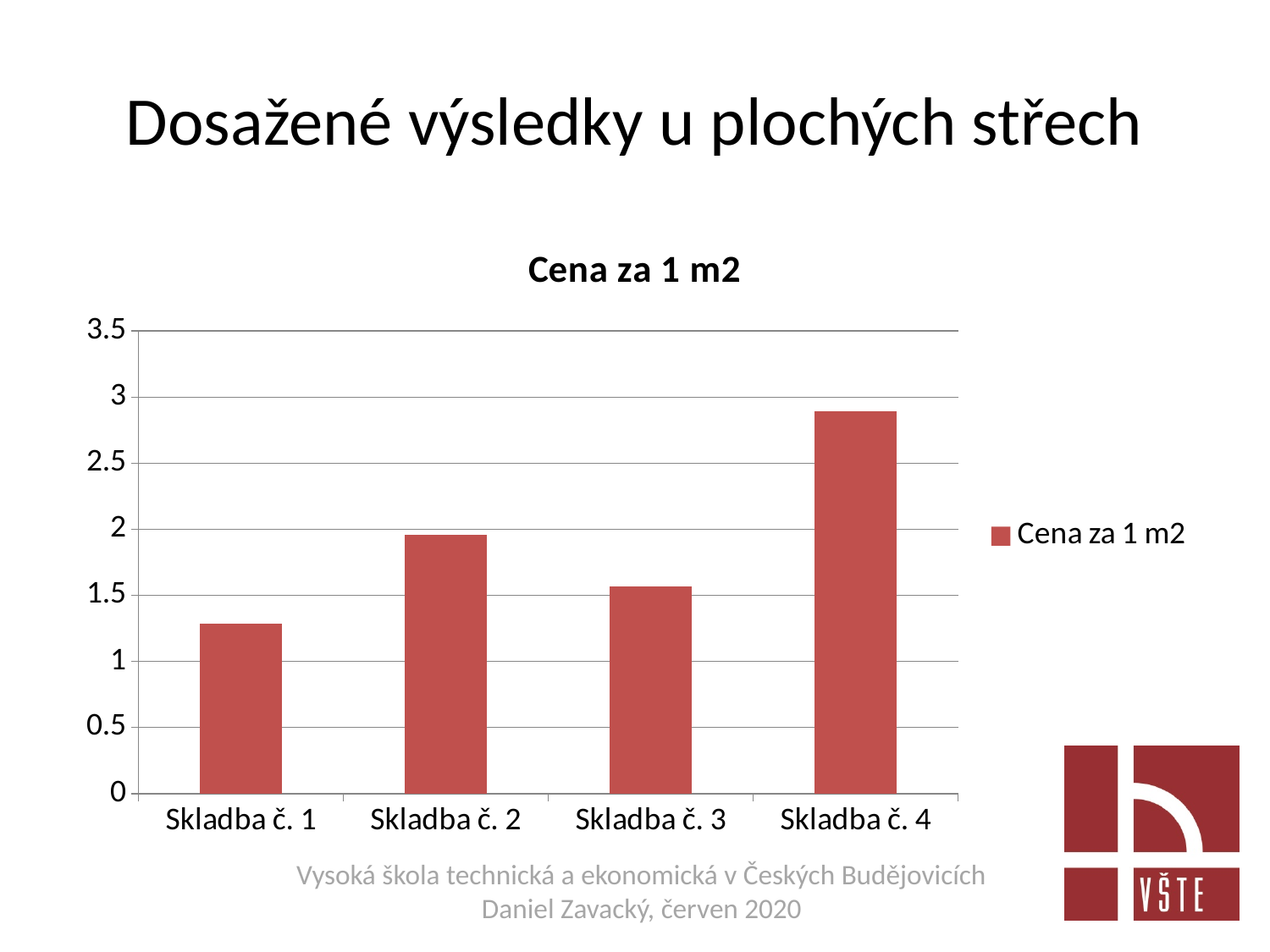
How many categories are shown on the x axis of the chart? 4 Which category has the lowest value for Cena za 1 m2? Skladba č. 1 Which is larger, the value for Skladba č. 2 or the value for Skladba č. 3? Skladba č. 2 What is the title of the chart? Cena za 1 m2 Is the value for Skladba č. 4 greater or less than 2.5? greater What type of chart is shown on the slide? bar chart How many series does the legend list? 1 Is the value for Skladba č. 2 greater or less than 1.5? greater Which is larger, the value for Skladba č. 1 or the value for Skladba č. 4? Skladba č. 4 Which category has the highest value for Cena za 1 m2? Skladba č. 4 Is the value for Skladba č. 3 greater or less than 2? less